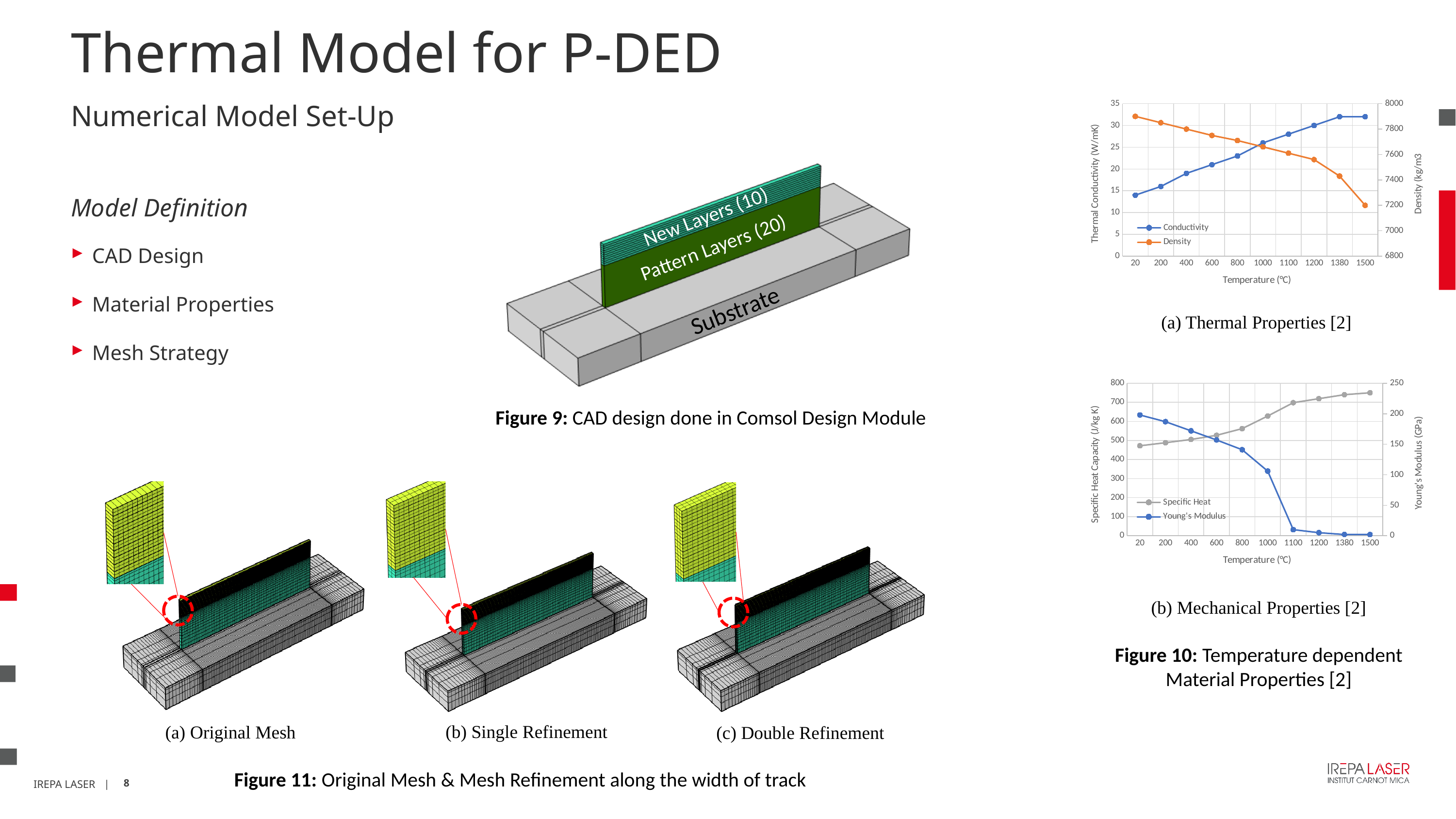
In the chart (a) Thermal Properties, is the Conductivity value at 20 °C greater or less than 15? less In the chart (a) Thermal Properties, at which temperature is Density lowest? 1500 In the chart (a) Thermal Properties, how many series does the legend list? 2 In the chart (a) Thermal Properties, does Conductivity rise or fall as temperature increases? Rise In the chart (a) Thermal Properties, does Density rise or fall as temperature increases? Fall In the chart (a) Thermal Properties, what kind of chart is shown? Line chart In the chart (a) Thermal Properties, is the Density value at 20 °C greater or less than 7800? greater In the chart (b) Mechanical Properties, does Young's Modulus rise or fall as temperature increases? Fall In the chart (b) Mechanical Properties, at which temperature is Young's Modulus highest? 20 In the chart (a) Thermal Properties, how many temperature points are plotted along the x axis? 10 In the chart (b) Mechanical Properties, is the Specific Heat value at 1500 °C greater or less than 700? greater In the chart (b) Mechanical Properties, how many series does the legend list? 2